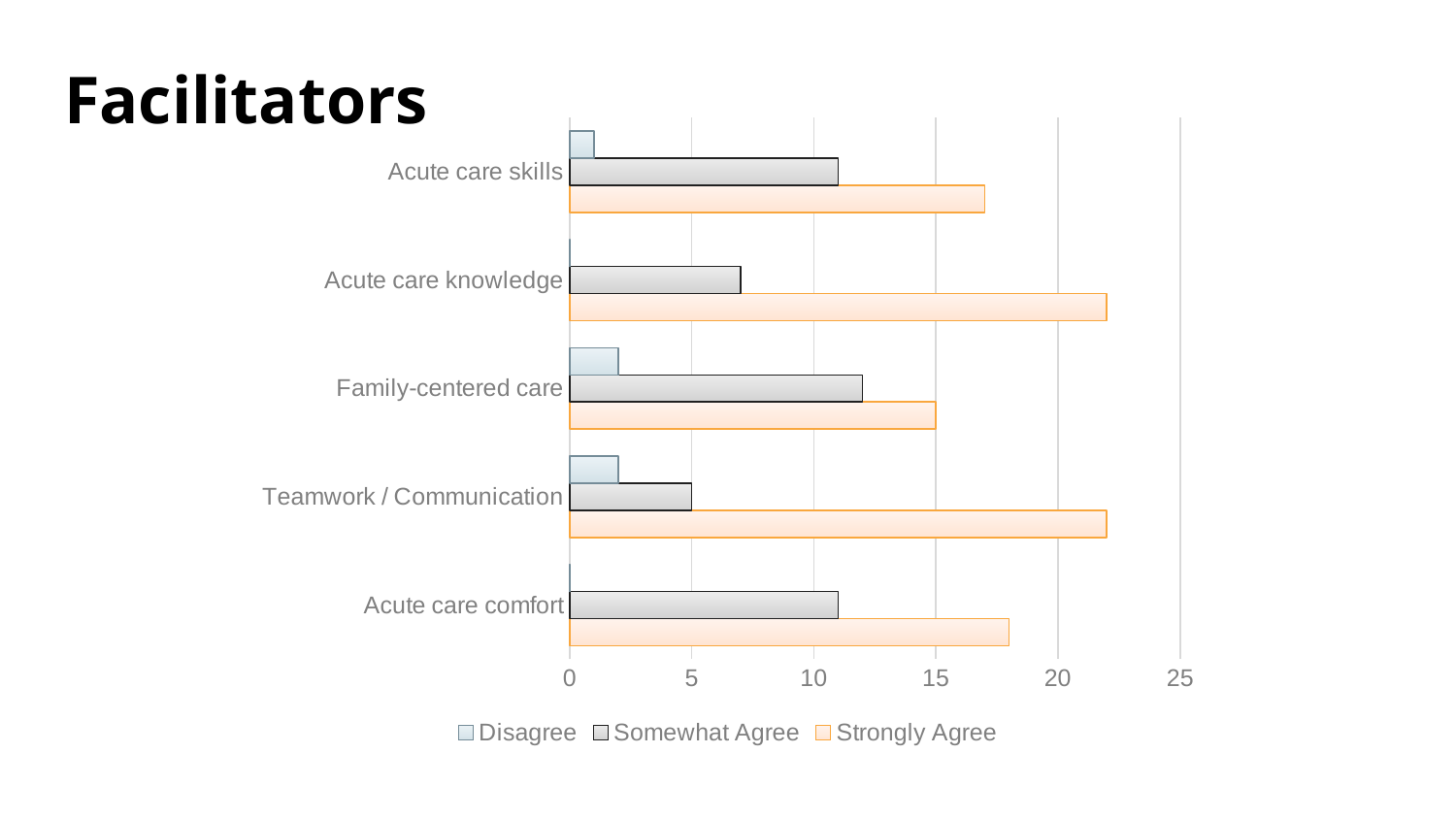
Is the Strongly Agree value for Acute care knowledge greater or less than 20? greater What is the Strongly Agree value for Family-centered care? 15 Is the Strongly Agree value for Acute care skills greater or less than 15? greater What is the title shown above the chart? Facilitators How many categories are plotted on the chart? 5 Which category has the lowest Somewhat Agree value? Teamwork / Communication Is the Somewhat Agree value for Acute care knowledge greater or less than 10? less Which is larger, the Somewhat Agree value for Acute care skills or for Acute care knowledge? Acute care skills How many series does the legend list? 3 What kind of chart is shown on the slide? bar chart What are the three series named in the legend? Disagree, Somewhat Agree, Strongly Agree What is the Somewhat Agree value for Teamwork / Communication? 5